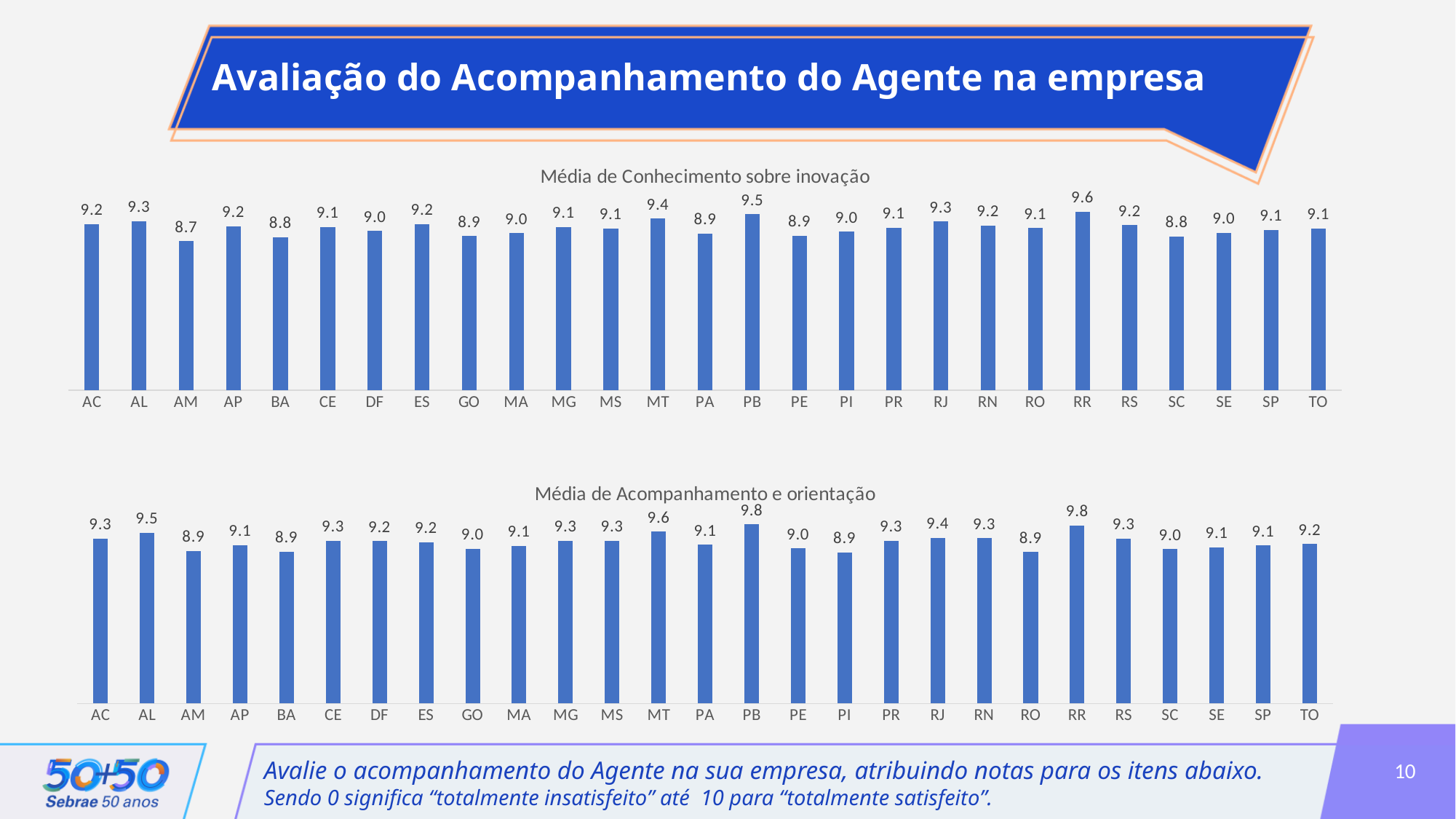
In the chart titled "Média de Conhecimento sobre inovação", which state has the highest value? RR In the chart titled "Média de Acompanhamento e orientação", what is the difference between the values for MT and GO? 0.6 What is the title of the bottom chart on the slide? Média de Acompanhamento e orientação How many states are shown in the chart titled "Média de Acompanhamento e orientação"? 27 In the chart titled "Média de Conhecimento sobre inovação", which is larger, the value for AL or the value for BA? AL In the chart titled "Média de Conhecimento sobre inovação", what is the difference between the values for PB and PE? 0.6 In the chart titled "Média de Acompanhamento e orientação", what is the value for PB? 9.8 In the chart titled "Média de Acompanhamento e orientação", which is larger, the value for AL or the value for PI? AL In the chart titled "Média de Conhecimento sobre inovação", which state has the lowest value? AM What kind of chart is the top chart on the slide? Bar chart In the chart titled "Média de Acompanhamento e orientação", what is the value for RJ? 9.4 In the chart titled "Média de Conhecimento sobre inovação", what is the value for MT? 9.4